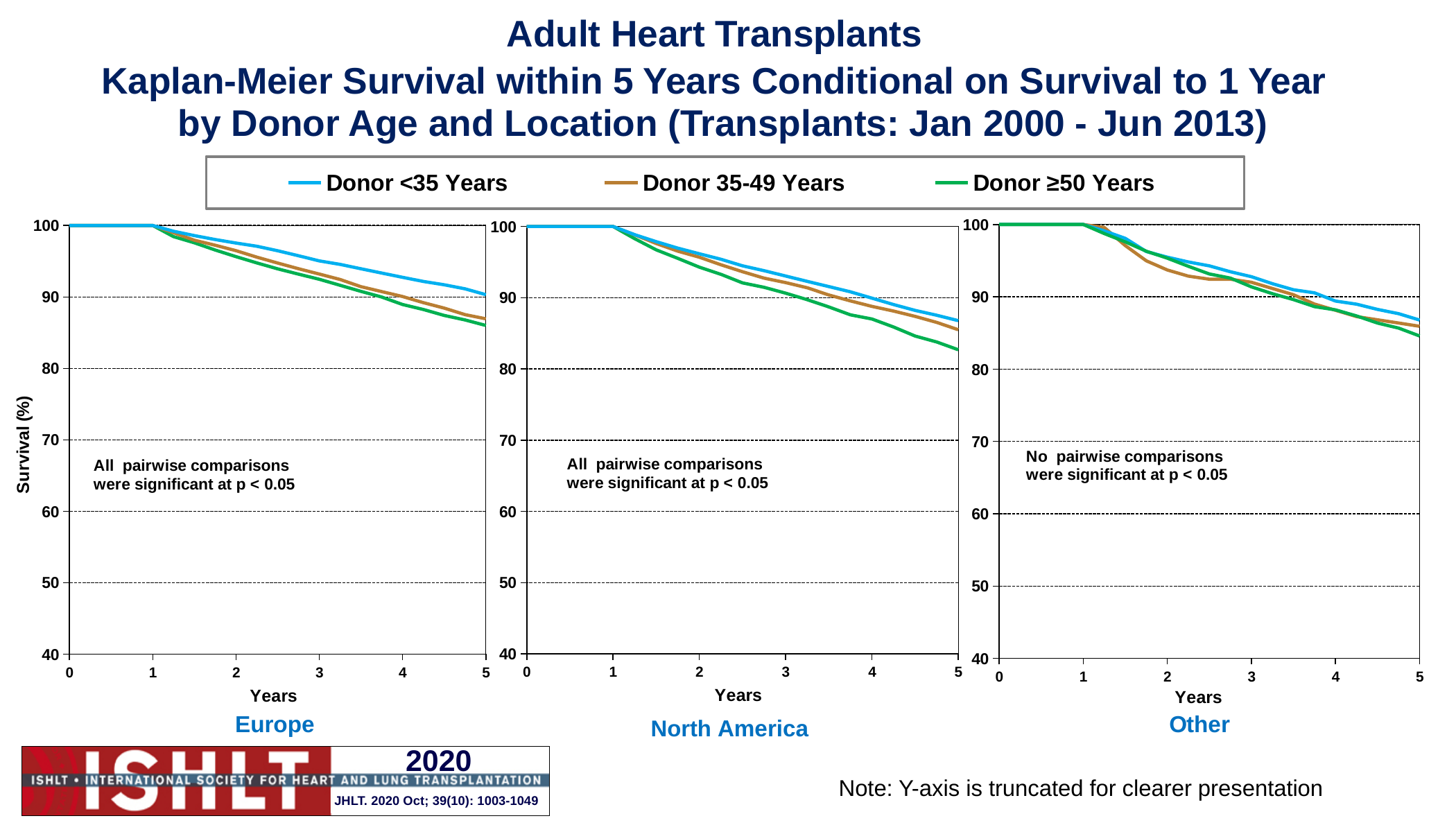
In the Europe chart, is the value for Donor ≥50 Years at 5 years greater or less than 90? less What does the annotation in the Other chart say about pairwise comparisons? No pairwise comparisons were significant at p < 0.05 How many charts are shown on the slide? 3 In the Europe chart, at 5 years, which is larger: the value for Donor <35 Years or Donor ≥50 Years? Donor <35 Years How many series does the legend list? 3 In the North America chart, is the value for Donor ≥50 Years at 5 years greater or less than 90? less In the North America chart, do the survival values rise or fall as years increase? Fall In the North America chart, which series has the highest survival at 5 years? Donor <35 Years In the Other chart, is the value for Donor <35 Years at 1 year greater or less than 90? greater What kind of chart is the Europe chart? Line chart In the North America chart, which series has the lowest survival at 5 years? Donor ≥50 Years What is the label of the x axis on the Europe chart? Years